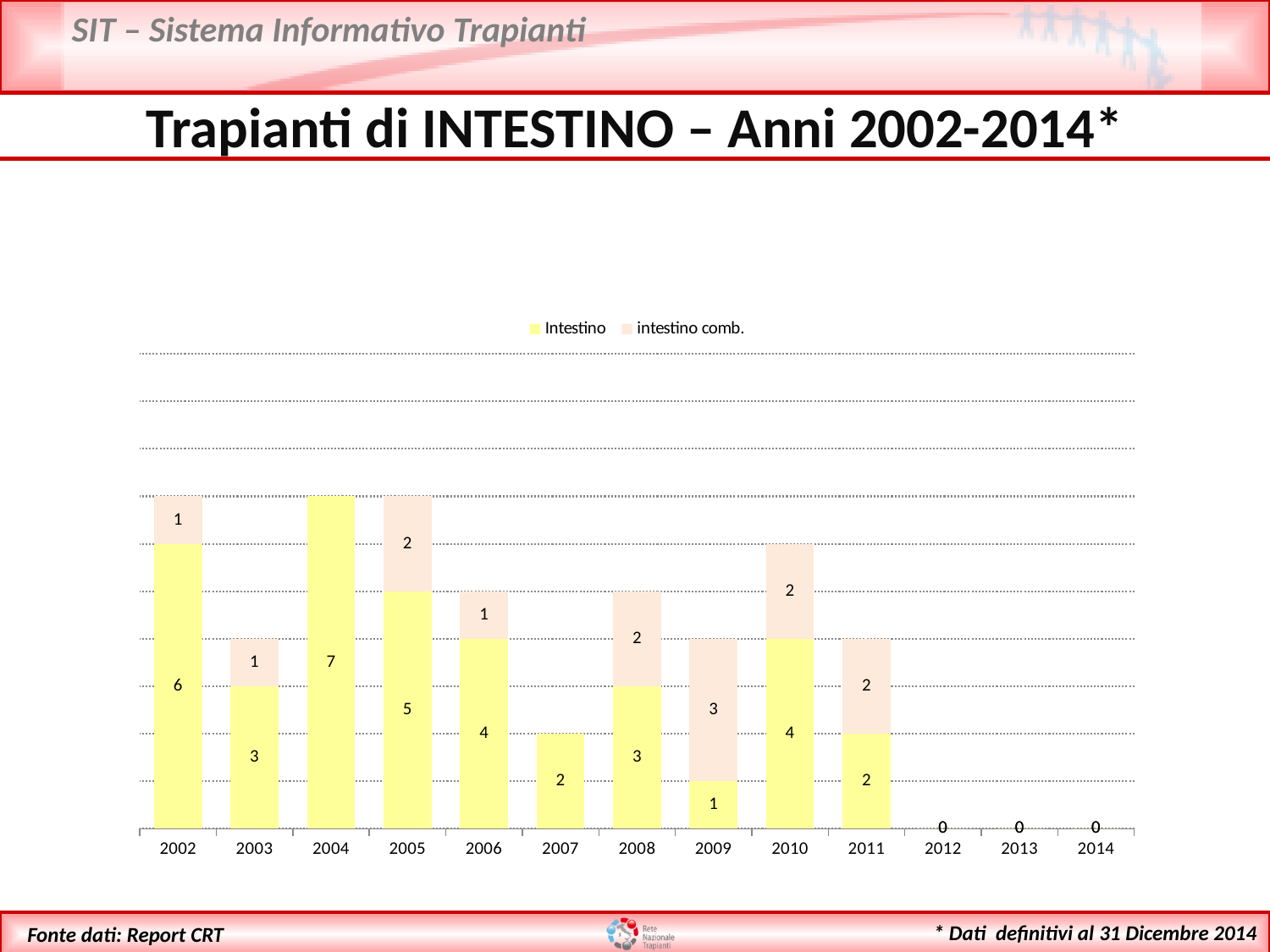
What is the value for Intestino in 2006? 4 How many years are shown on the x axis? 13 Which year has the highest value for the Intestino series? 2004 What is the total of the stacked bar for 2005? 7 What is the total of the stacked bar for 2010? 6 How many series does the legend list? 2 Which year has the highest value for the intestino comb. series? 2009 What is the value for Intestino in 2004? 7 What kind of chart is shown on the slide? Stacked bar chart What is the value for intestino comb. in 2009? 3 What is the difference between the Intestino values for 2002 and 2003? 3 In 2009, which is larger: the Intestino value or the intestino comb. value? intestino comb.